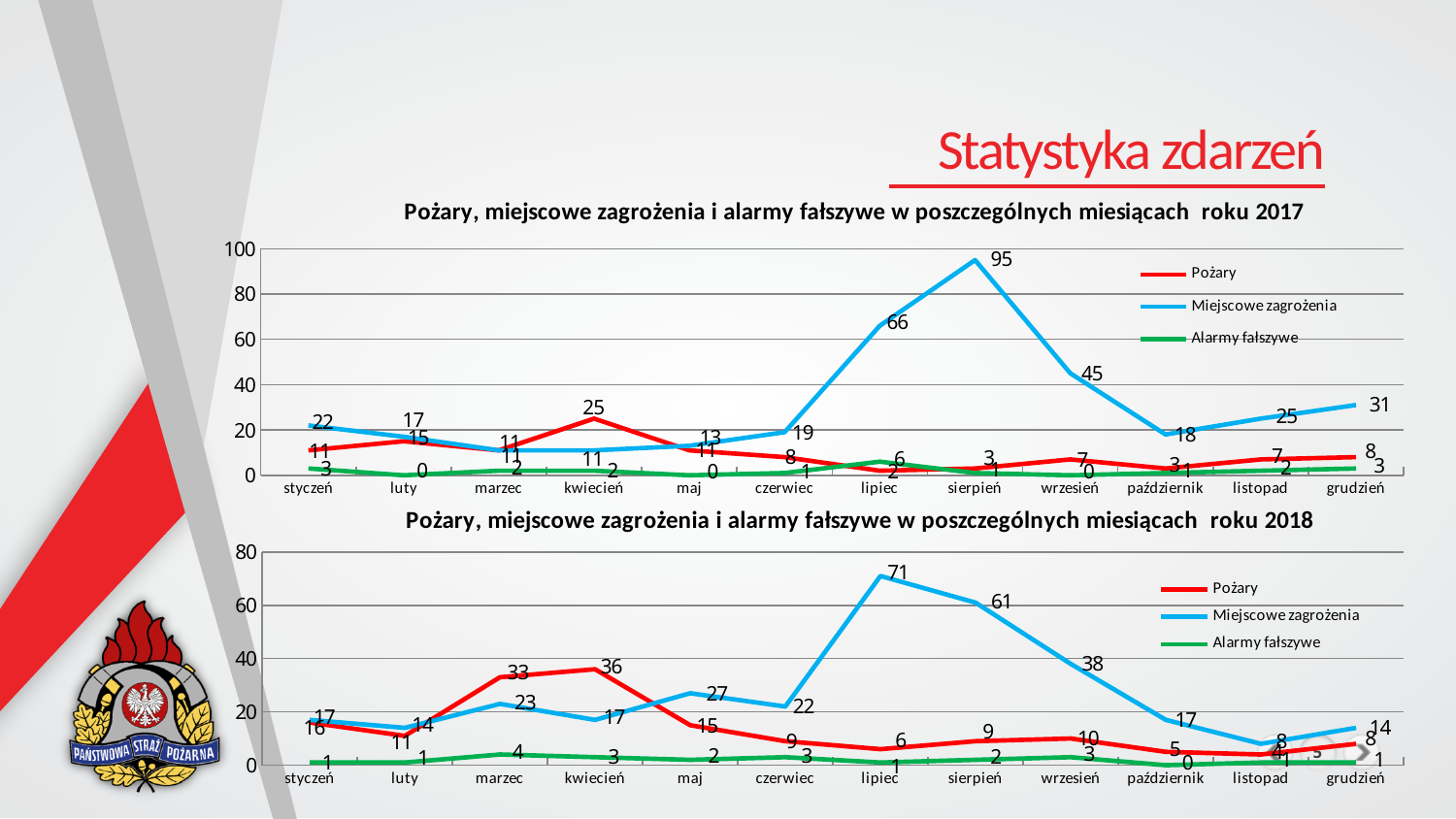
In the 2018 chart, what is the value of Miejscowe zagrożenia in lipiec? 71 In the 2017 chart, what is the difference between Miejscowe zagrożenia in sierpień and in lipiec? 29 In the 2018 chart, what is the value of Pożary in kwiecień? 36 In the 2017 chart, what is the value of Miejscowe zagrożenia in sierpień? 95 In the 2018 chart, what is the difference between Miejscowe zagrożenia in lipiec and in sierpień? 10 In the 2017 chart, how many series does the legend list? 3 In the 2018 chart, in which month is Pożary highest? kwiecień In the 2018 chart, which is larger in marzec: Pożary or Miejscowe zagrożenia? Pożary In the 2017 chart, what is the value of Pożary in kwiecień? 25 In the 2017 chart, in which month is Miejscowe zagrożenia highest? sierpień What type of chart is the 2017 chart? line chart How many months are shown on the x axis of the 2018 chart? 12